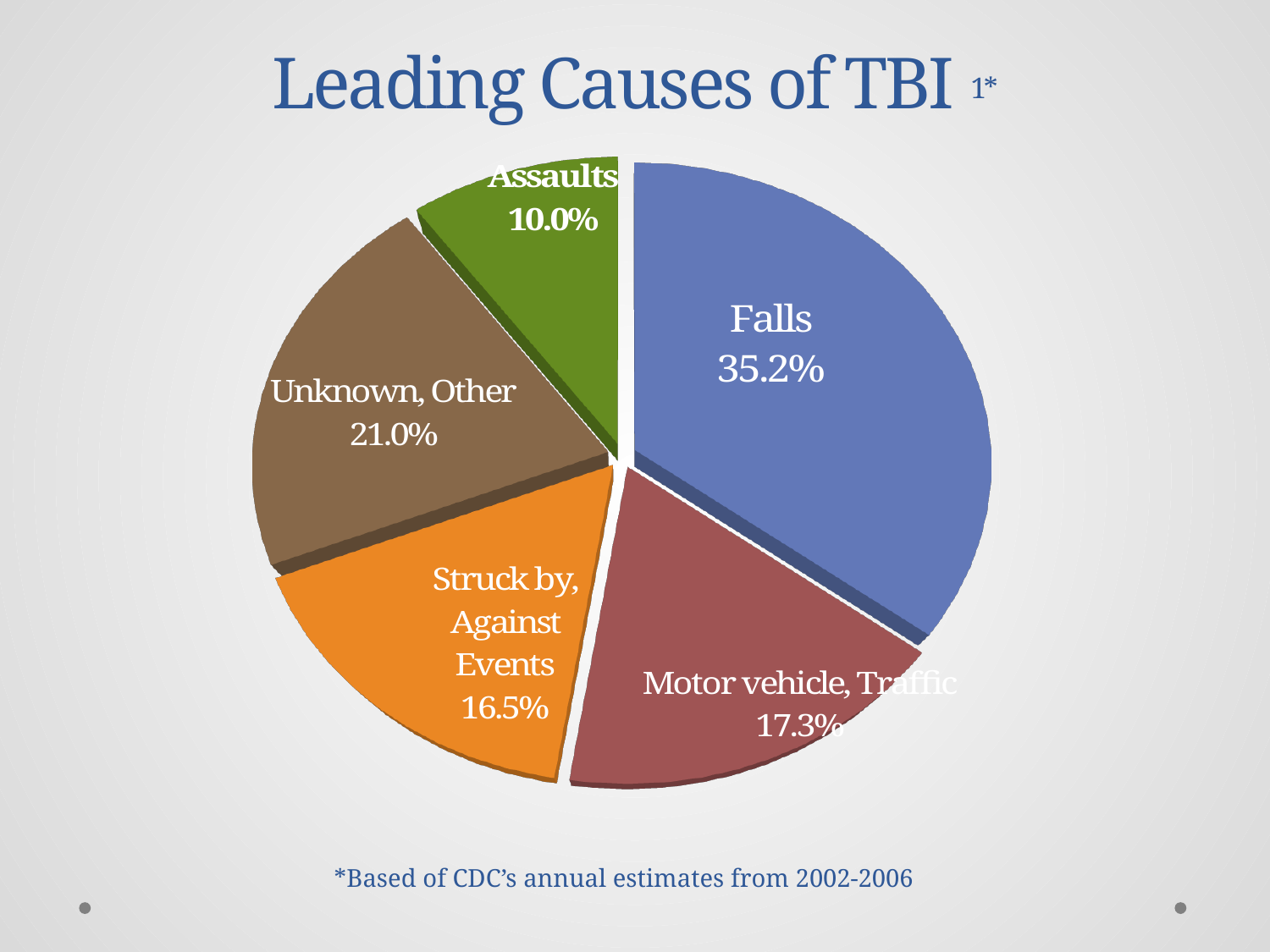
What percentage is shown for Assaults? 10.0% Which cause has the largest share of the pie? Falls How many slices does the pie chart have? 5 What percentage of TBI cases is attributed to Falls? 35.2% What percentage is shown for Struck by, Against Events? 16.5% Which is larger, the share for Unknown, Other or the share for Motor vehicle, Traffic? Unknown, Other What type of chart is shown on the slide? pie chart What is the title of the chart? Leading Causes of TBI What percentage is shown for Unknown, Other? 21.0% Which cause has the smallest share of the pie? Assaults What is the difference in percentage points between Falls and Unknown, Other? 14.2 What percentage is shown for Motor vehicle, Traffic? 17.3%